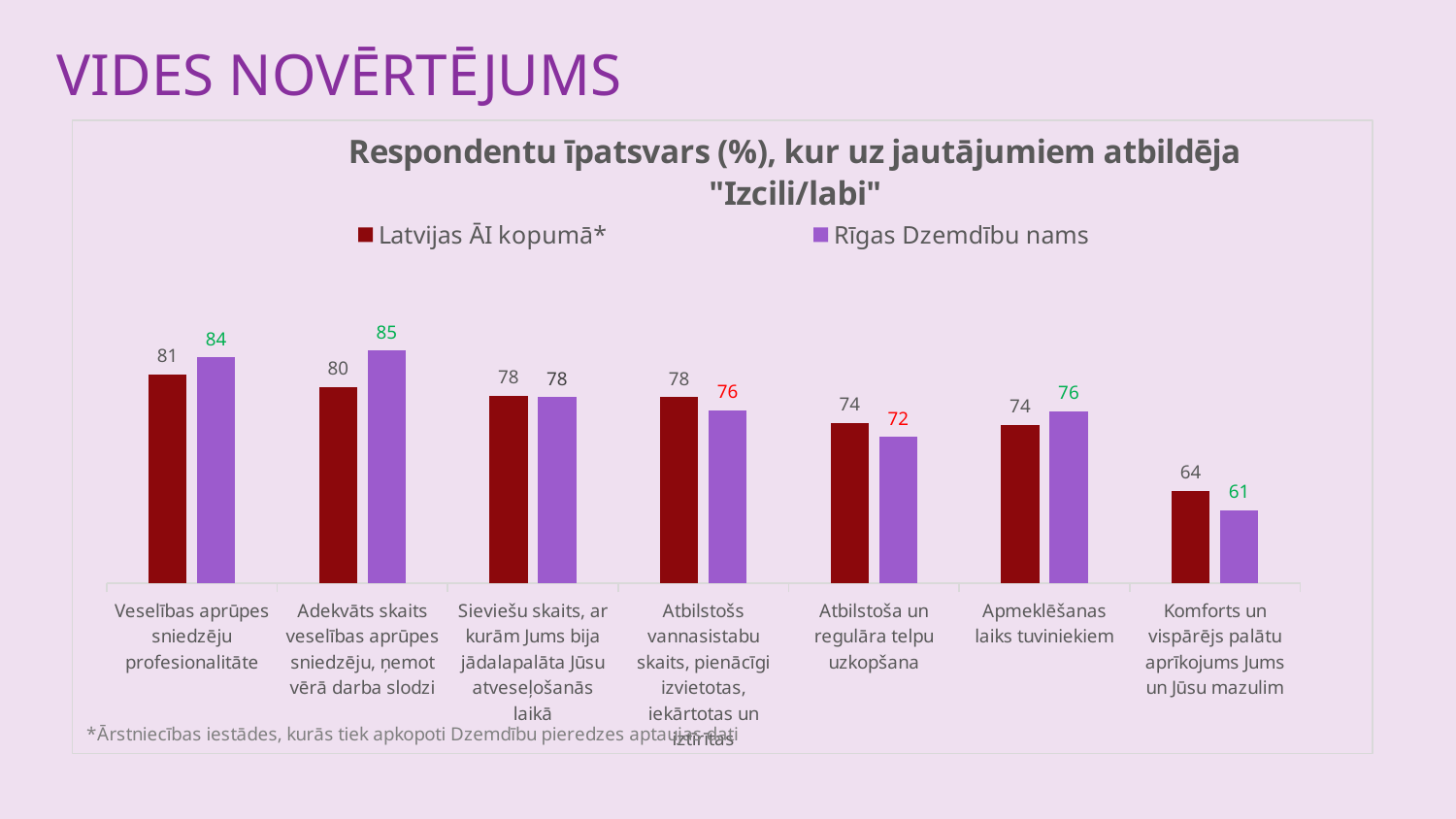
What is the value for "Rīgas Dzemdību nams" in the category "Komforts un vispārējs palātu aprīkojums Jums un Jūsu mazulim"? 61 What type of chart is shown on the slide? bar chart Which category has the lowest value for "Latvijas ĀI kopumā*"? Komforts un vispārējs palātu aprīkojums Jums un Jūsu mazulim In the category "Atbilstoša un regulāra telpu uzkopšana", which series has the larger value? Latvijas ĀI kopumā* What is the value for "Rīgas Dzemdību nams" in the category "Veselības aprūpes sniedzēju profesionalitāte"? 84 What is the value for "Latvijas ĀI kopumā*" in the category "Atbilstoša un regulāra telpu uzkopšana"? 74 What is the difference between the "Rīgas Dzemdību nams" and "Latvijas ĀI kopumā*" values in the category "Adekvāts skaits veselības aprūpes sniedzēju, ņemot vērā darba slodzi"? 5 How many series does the legend list? 2 Which category has the highest value for "Rīgas Dzemdību nams"? Adekvāts skaits veselības aprūpes sniedzēju, ņemot vērā darba slodzi What is the title of the chart? Respondentu īpatsvars (%), kur uz jautājumiem atbildēja "Izcili/labi" How many categories are shown on the x axis? 7 In the category "Apmeklēšanas laiks tuviniekiem", which series has the larger value? Rīgas Dzemdību nams